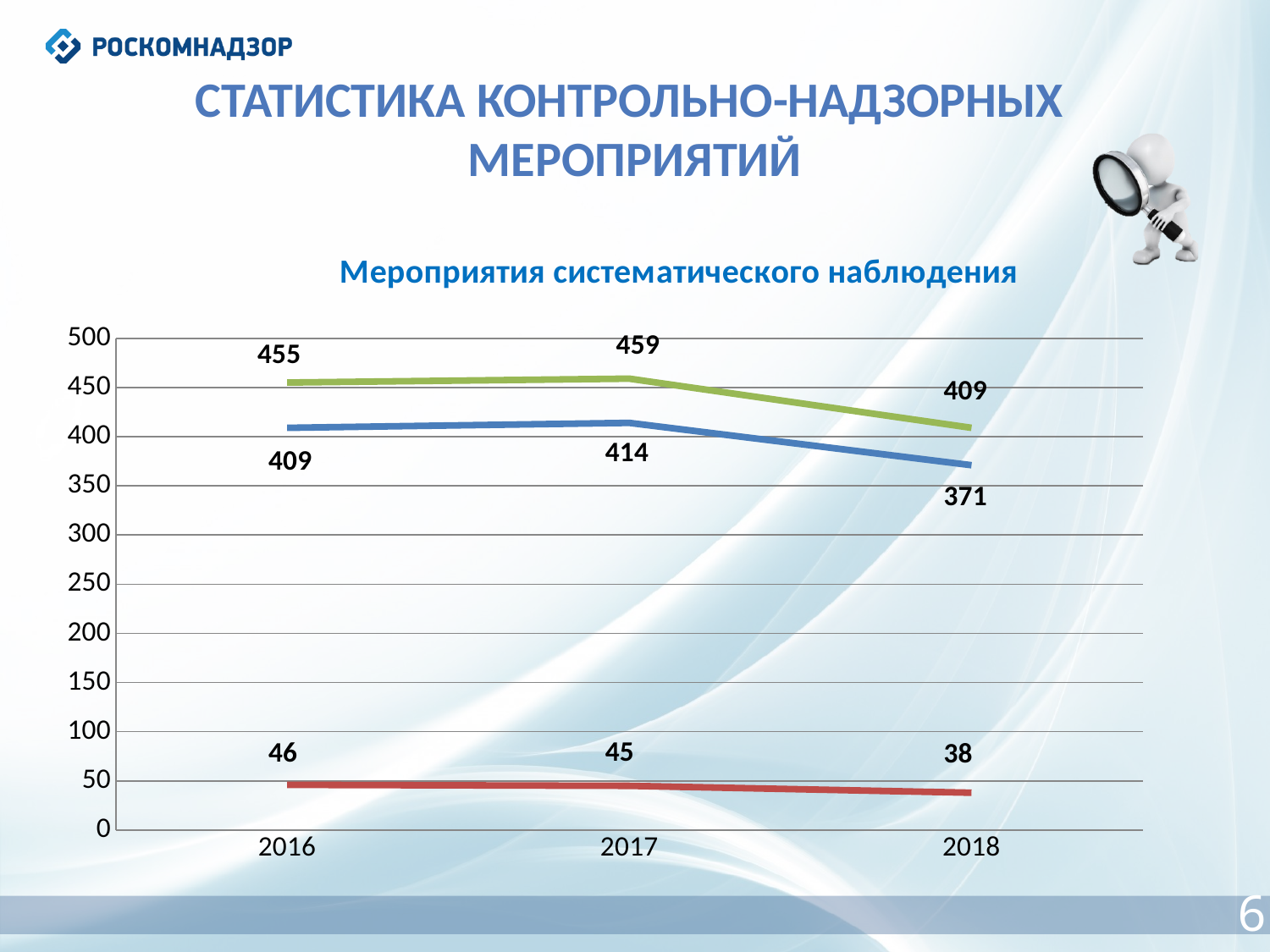
What is the title of the chart? Мероприятия систематического наблюдения What is the value of the red line in 2016? 46 What is the difference between the green line's value in 2017 and its value in 2018? 50 What kind of chart is shown on the slide? line chart In which year does the green line reach its highest value? 2017 What is the value of the blue line in 2018? 371 In which year does the blue line have its lowest value? 2018 Is the value of the blue line in 2018 greater or less than 400? less What is the value of the green line in 2017? 459 How many years are shown on the x axis of the chart? 3 Which is larger: the blue line's value in 2016 or its value in 2017? 2017 Does the red line rise or fall from 2017 to 2018? fall